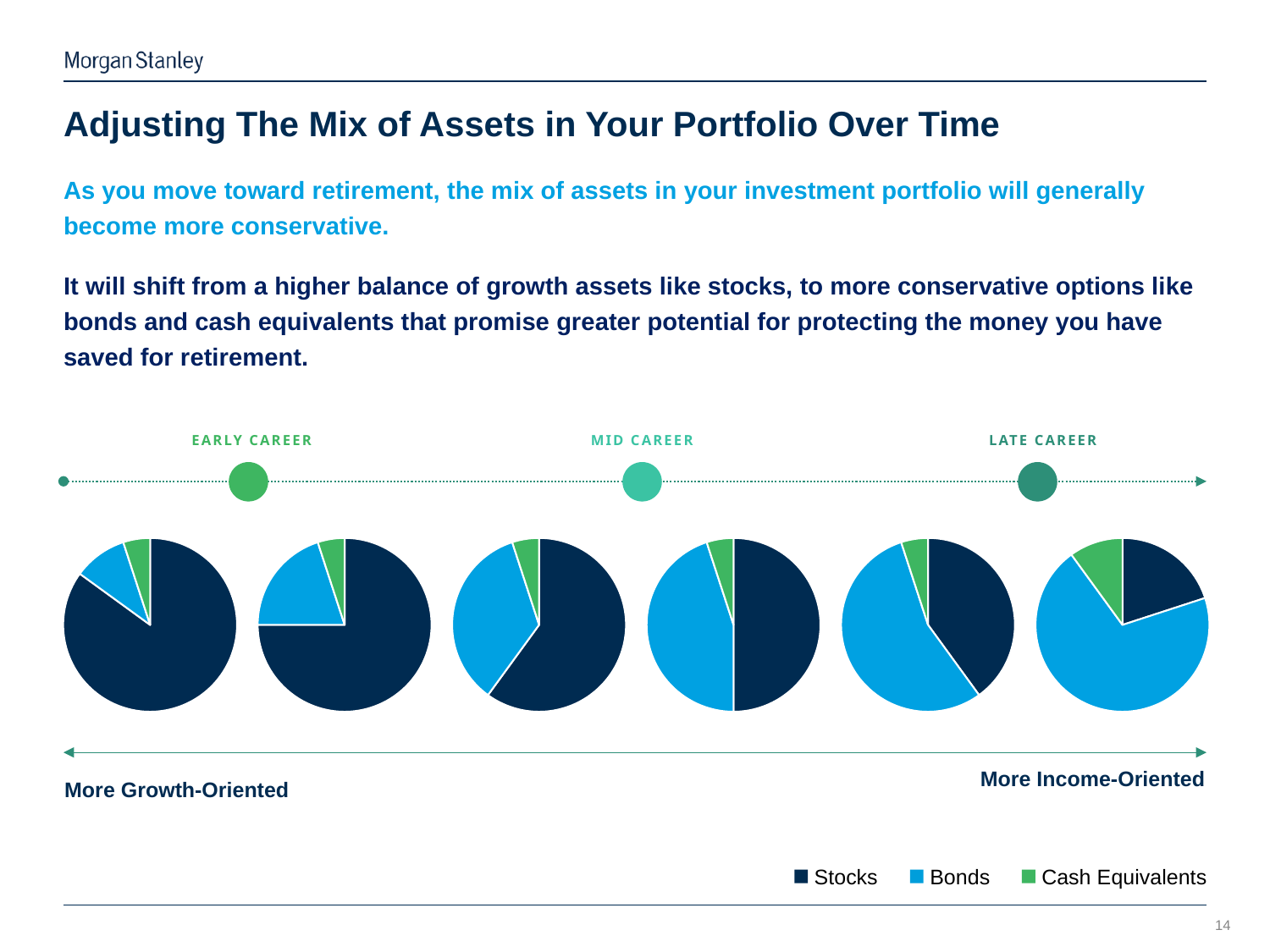
How many pie charts are shown on the slide? 6 Which colour represents Bonds in the pie charts? Light blue What are the three categories listed in the legend? Stocks, Bonds, Cash Equivalents In the rightmost pie chart, which category has the smallest slice? Cash Equivalents In the rightmost pie chart, which category has the largest slice? Bonds Moving from the leftmost pie chart to the rightmost, does the Stocks share rise or fall? Fall How many series does the legend list? 3 What kind of charts are shown on the slide? Pie charts In the leftmost pie chart, which category has the smallest slice? Cash Equivalents In the leftmost pie chart, which category has the largest slice? Stocks In the fifth pie chart from the left, which slice is larger, Stocks or Bonds? Bonds In the second pie chart from the left, which slice is larger, Stocks or Bonds? Stocks